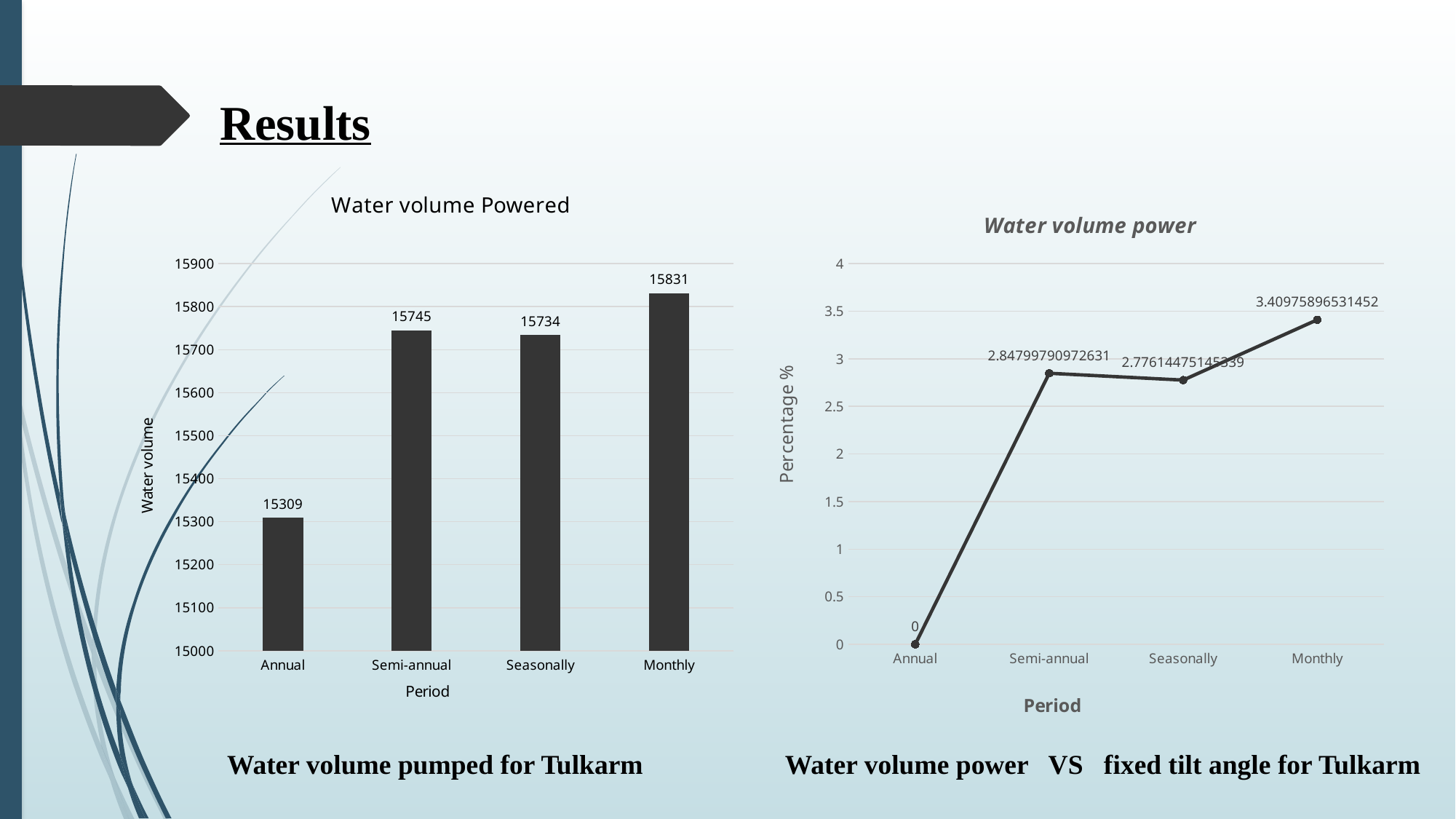
In the 'Water volume power' line chart, what is the value for Monthly? 3.40975896531452 What kind of chart is the 'Water volume Powered' chart on the left? Bar chart In the 'Water volume power' line chart, what is the value for Annual? 0 In the 'Water volume power' line chart, is the value for Semi-annual greater or less than 2.5? greater In the 'Water volume Powered' bar chart, what is the difference between the Monthly and Annual values? 522 In the 'Water volume Powered' bar chart, what is the value for Annual? 15309 In the 'Water volume Powered' bar chart, how many periods are shown on the x axis? 4 In the 'Water volume Powered' bar chart, which period has the highest water volume? Monthly In the 'Water volume Powered' bar chart, which period has the lowest water volume? Annual What is the y-axis label of the 'Water volume power' line chart on the right? Percentage % In the 'Water volume Powered' bar chart, which is larger, Semi-annual or Seasonally? Semi-annual In the 'Water volume Powered' bar chart, what is the value for Monthly? 15831